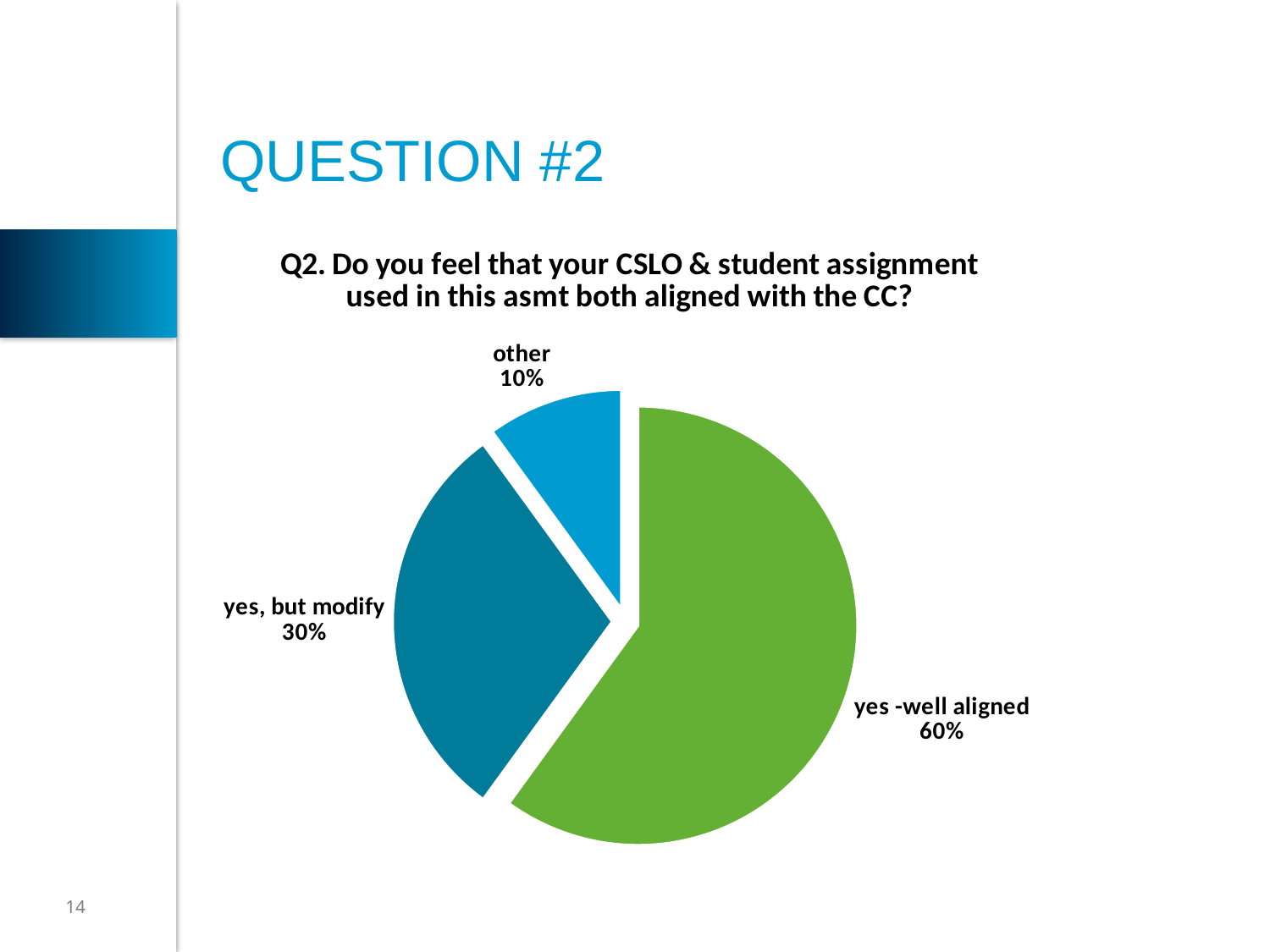
Which category has the largest share of the pie? yes -well aligned Which is larger, the share for 'yes, but modify' or the share for 'other'? yes, but modify What percentage of responses are 'yes -well aligned'? 60% What is the difference in percentage points between 'yes -well aligned' and 'yes, but modify'? 30 Which category has the smallest share of the pie? other What is the difference in percentage points between 'yes, but modify' and 'other'? 20 How many slices does the pie chart have? 3 What colour is the 'yes -well aligned' slice? green What percentage of responses are 'yes, but modify'? 30% What is the title of the chart? Q2. Do you feel that your CSLO & student assignment used in this asmt both aligned with the CC? What percentage of responses are 'other'? 10% What kind of chart is shown on the slide? pie chart